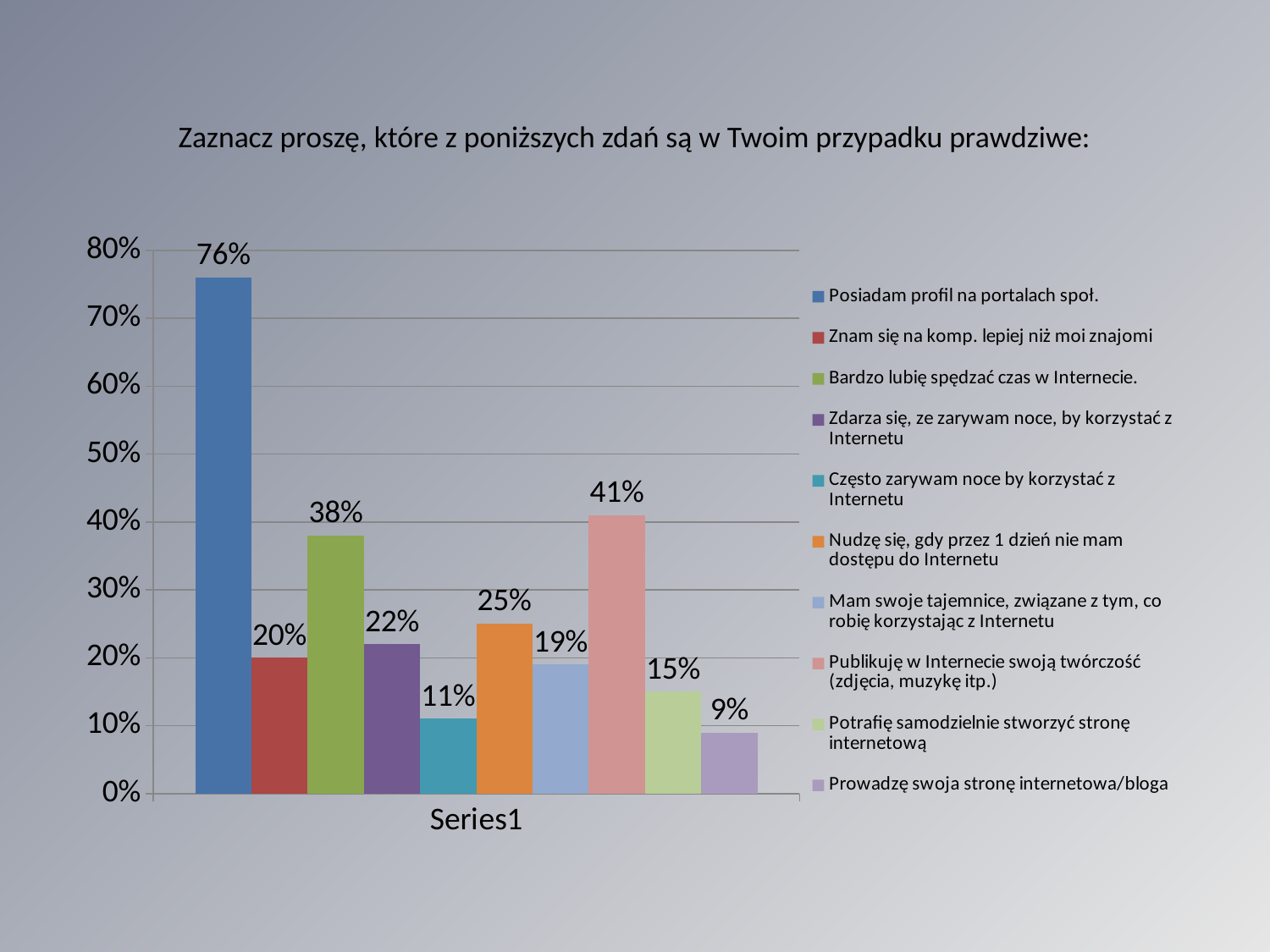
What kind of chart is shown on the slide? bar chart What is the value for "Publikuję w Internecie swoją twórczość (zdjęcia, muzykę itp.)"? 41% Which legend entry has the lowest value? Prowadzę swoja stronę internetowa/bloga How many entries does the legend list? 10 How many bars are plotted on the chart? 10 What is the value for "Często zarywam noce by korzystać z Internetu"? 11% Which is larger: the value for "Znam się na komp. lepiej niż moi znajomi" or the value for "Zdarza się, ze zarywam noce, by korzystać z Internetu"? Zdarza się, ze zarywam noce, by korzystać z Internetu What is the value for "Nudzę się, gdy przez 1 dzień nie mam dostępu do Internetu"? 25% Which legend entry has the highest value? Posiadam profil na portalach społ. What is the difference between the values for "Posiadam profil na portalach społ." and "Bardzo lubię spędzać czas w Internecie."? 38% What is the value for "Posiadam profil na portalach społ."? 76% What is the label shown on the x axis below the bars? Series1